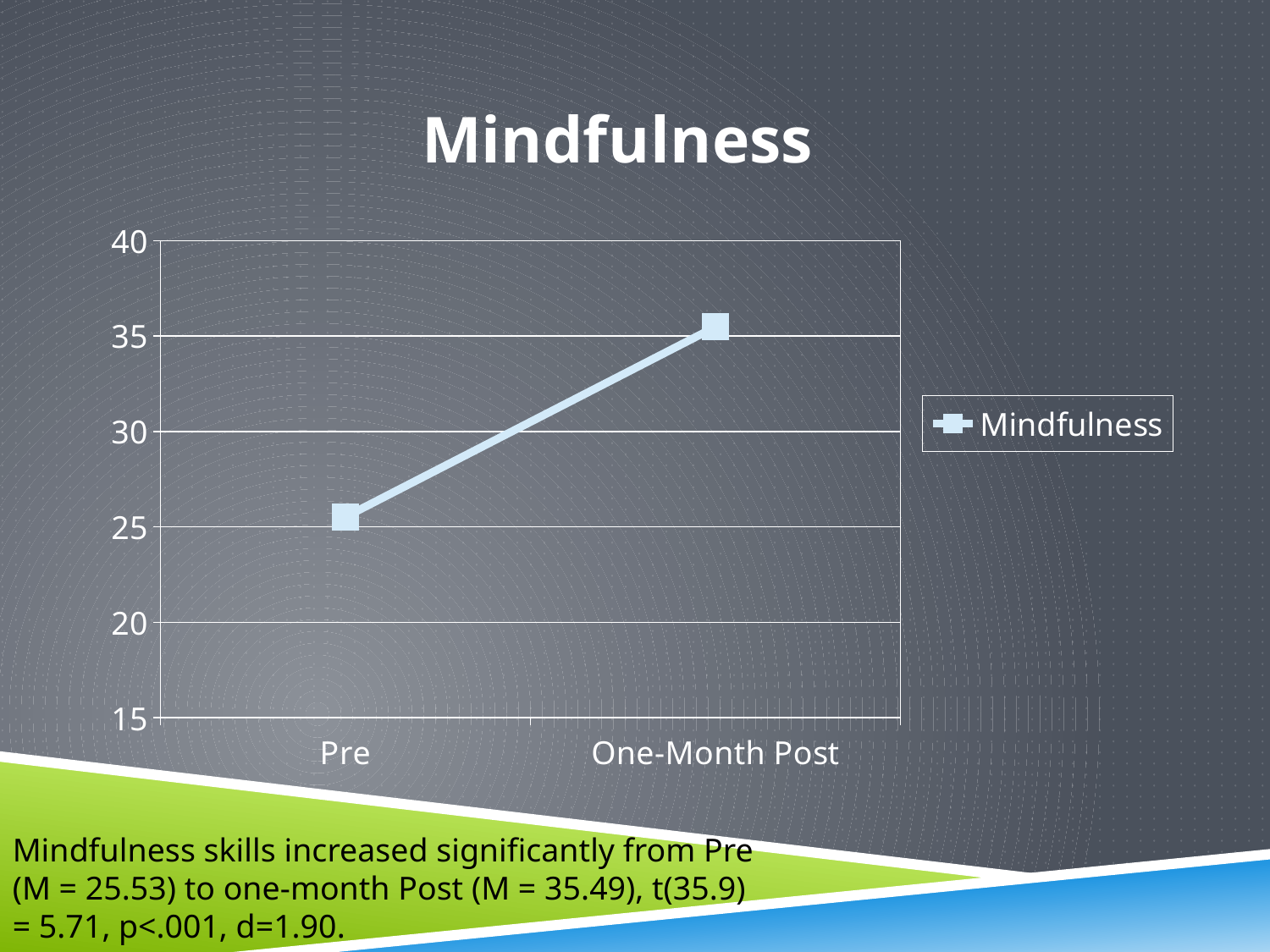
Which category has the higher Mindfulness value, Pre or One-Month Post? One-Month Post Which category has the lowest Mindfulness value? Pre How many series does the legend list? 1 Does the Mindfulness value rise or fall from Pre to One-Month Post? rise What are the two categories on the x axis? Pre and One-Month Post According to the text on the slide, what is the mean Mindfulness score at Pre? 25.53 According to the text on the slide, what is the mean Mindfulness score at one-month Post? 35.49 Is the Mindfulness value at Pre greater or less than 30? less Is the Mindfulness value at One-Month Post greater or less than 35? greater What is the title of the chart? Mindfulness What kind of chart is shown on the slide? line chart How many points are plotted on the Mindfulness line? 2